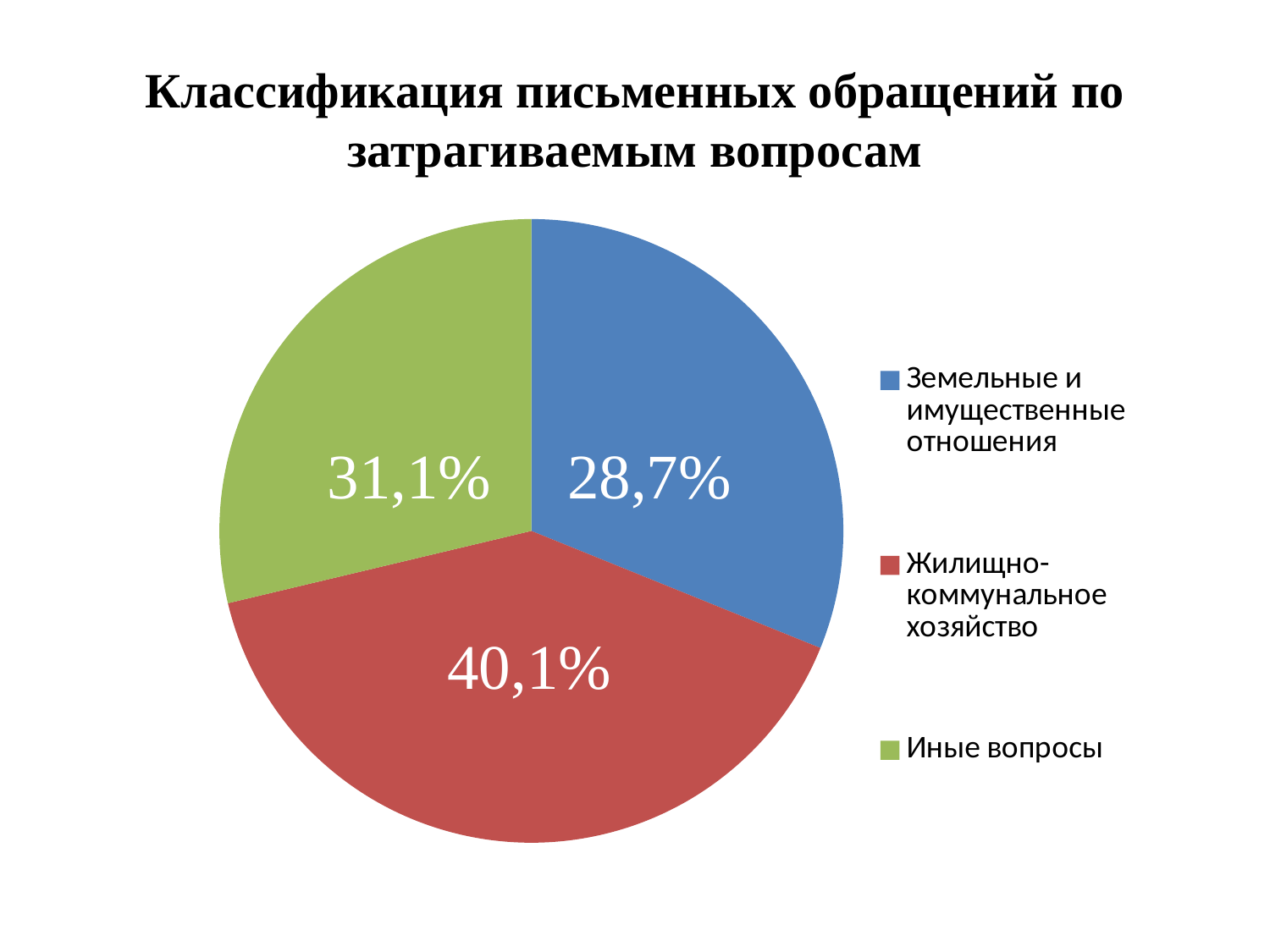
Which category has the largest slice of the pie? Жилищно-коммунальное хозяйство How many entries does the legend list? 3 What is the value shown for Иные вопросы? 31,1% Which category has the smallest slice of the pie? Земельные и имущественные отношения Which is larger: the share of Иные вопросы or the share of Земельные и имущественные отношения? Иные вопросы What is the difference between the shares of Иные вопросы and Земельные и имущественные отношения? 2,4% What is the difference between the shares of Жилищно-коммунальное хозяйство and Земельные и имущественные отношения? 11,4% What kind of chart is shown on the slide? pie chart How many slices does the pie chart have? 3 What colour is the slice for Иные вопросы? green What share of the pie does Жилищно-коммунальное хозяйство have? 40,1% What is the value shown for Земельные и имущественные отношения? 28,7%